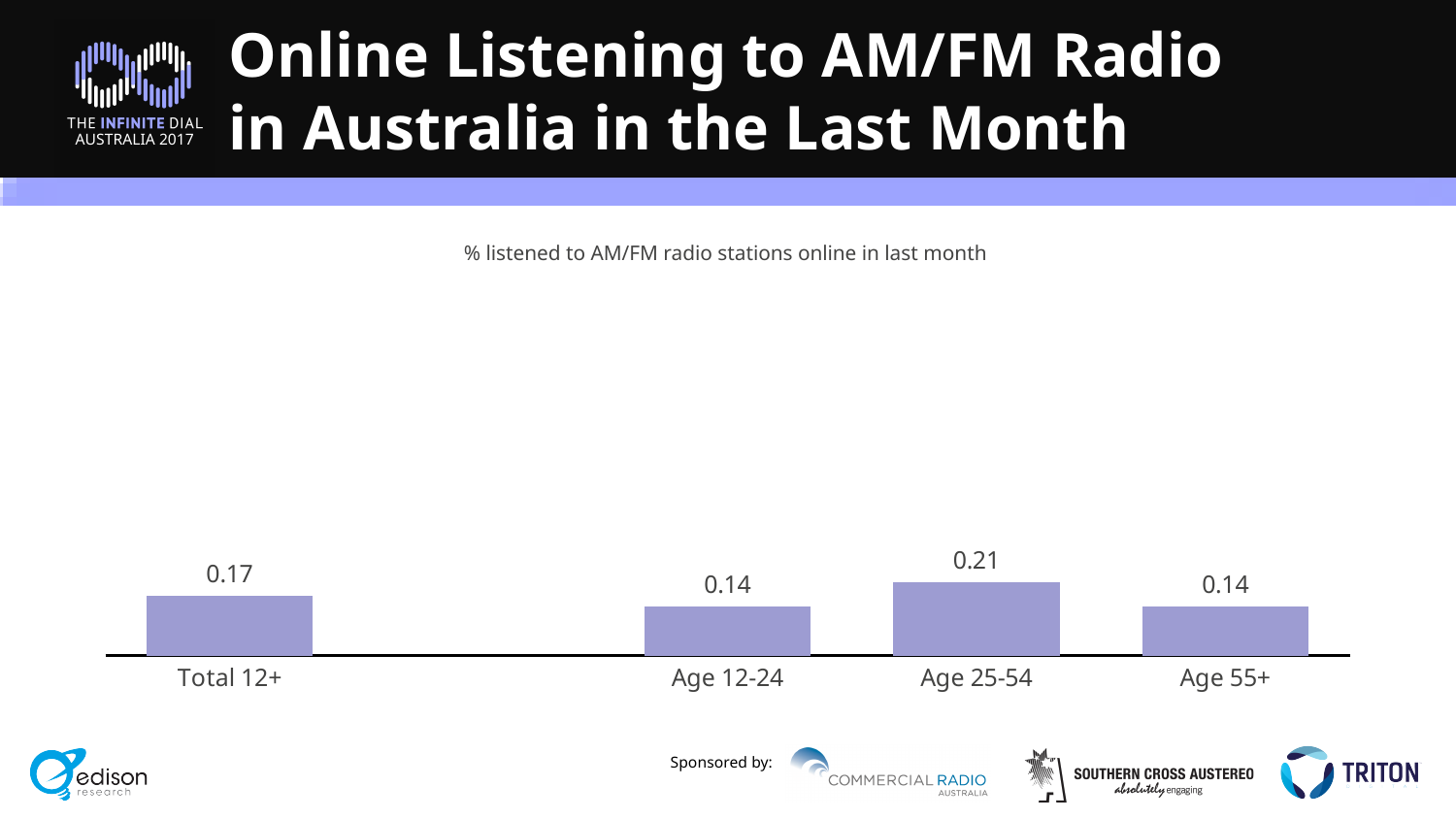
What is the value for Total 12+? 0.17 What is the value for Age 12-24? 0.14 What is the difference between the values for Total 12+ and Age 55+? 0.03 Which is larger, the value for Total 12+ or the value for Age 25-54? Age 25-54 What is the value for Age 55+? 0.14 Which two age categories share the same value? Age 12-24 and Age 55+ What kind of chart is shown on the slide? Bar chart Which category has the highest value? Age 25-54 What is the difference between the values for Age 25-54 and Age 12-24? 0.07 How many categories are shown on the x axis? 4 What is the value for Age 25-54? 0.21 What is the subtitle text above the chart? % listened to AM/FM radio stations online in last month